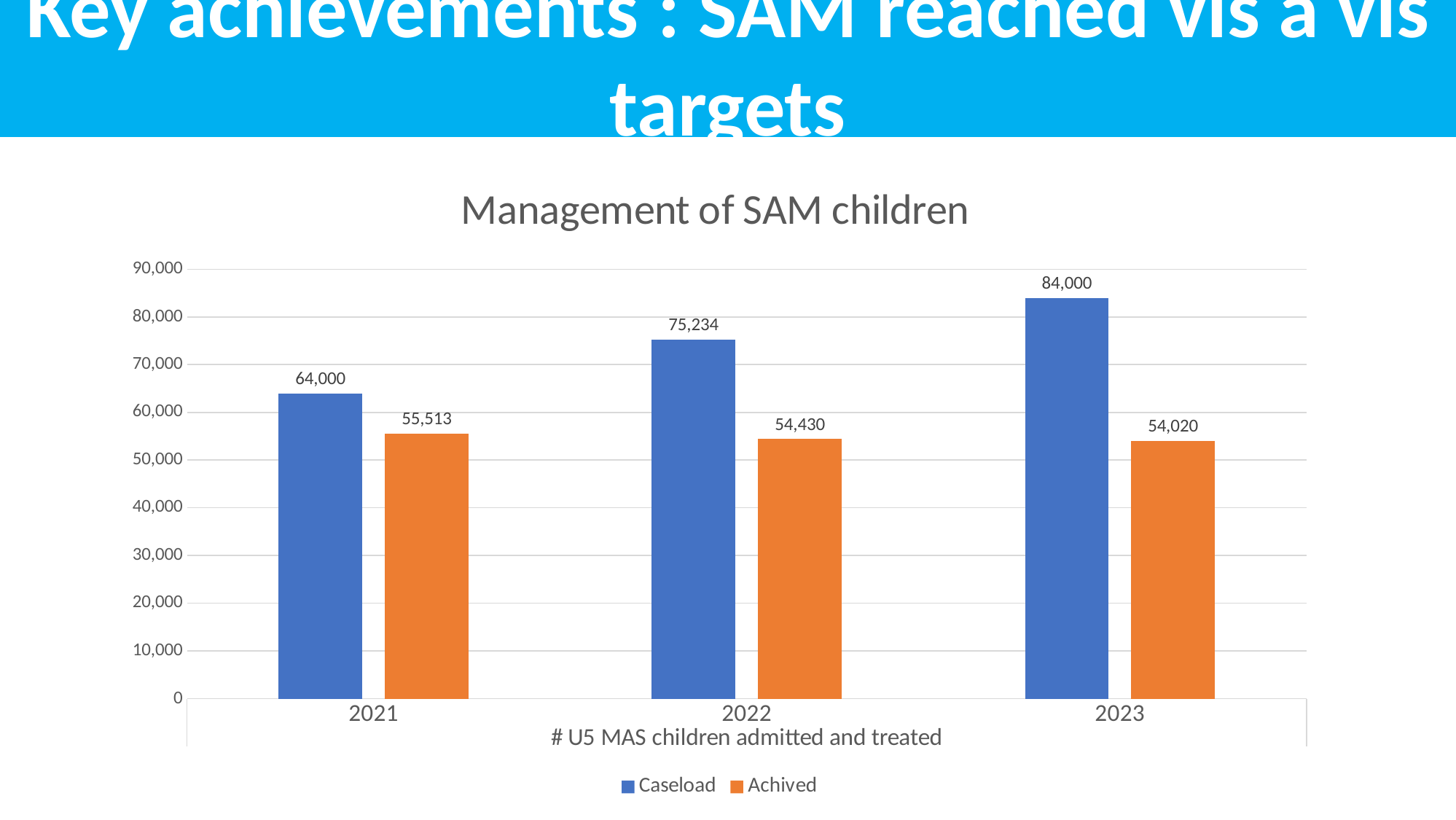
Does the Caseload series rise or fall from 2021 to 2023? Rise What kind of chart is shown on the slide? Bar chart What is the Caseload value for 2022? 75,234 Which year has the lowest Achived value? 2023 What is the Achived value for 2023? 54,020 Which is larger, the Achived value for 2021 or the Achived value for 2022? 2021 What is the difference between the Caseload values for 2022 and 2021? 11,234 What is the difference between the Caseload and Achived values for 2023? 29,980 How many series does the legend list? 2 What is the Achived value for 2021? 55,513 How many years are shown on the x axis? 3 Which year has the highest Caseload value? 2023